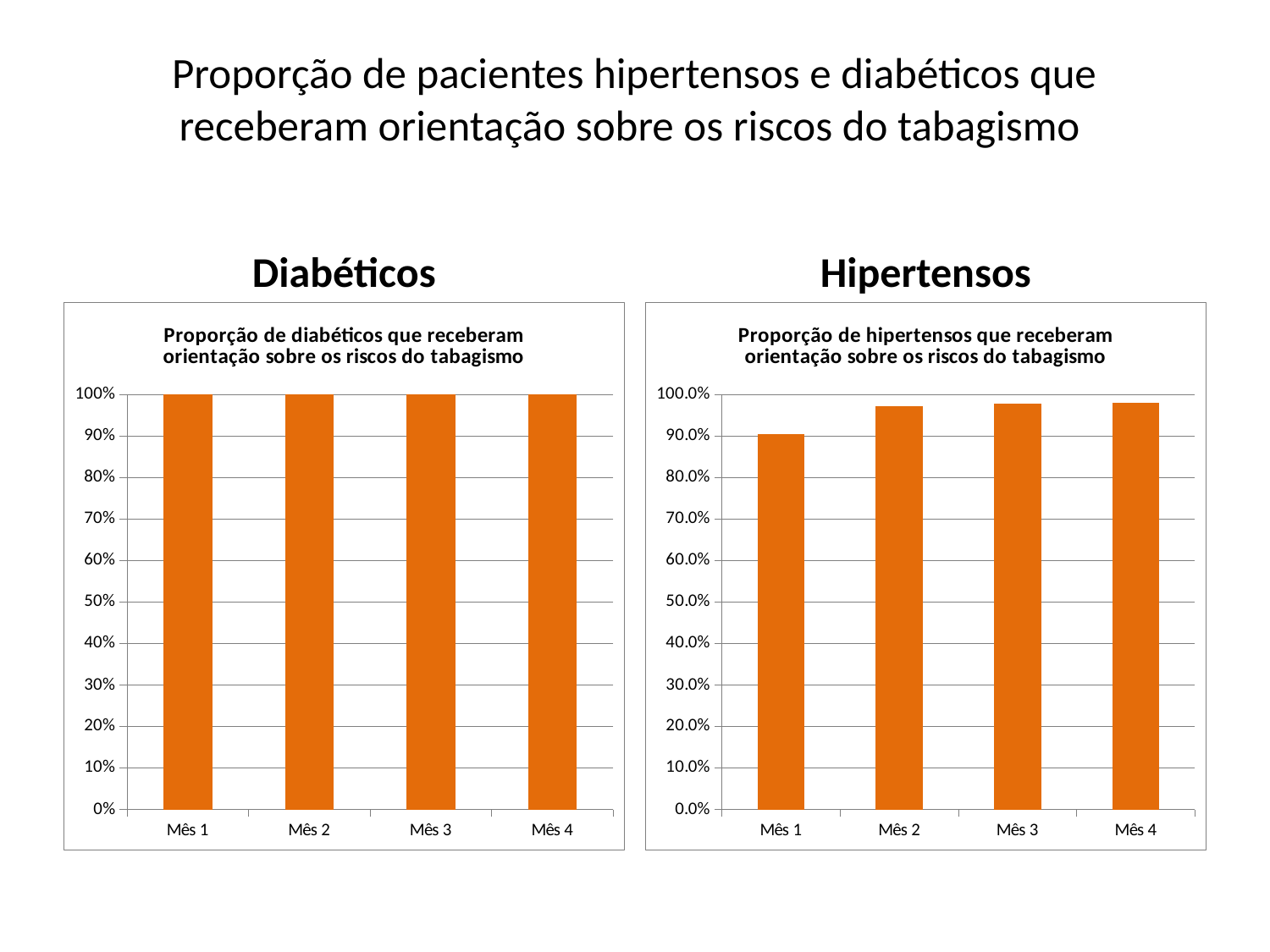
In the Hipertensos chart, which month has the lowest value? Mês 1 In the Diabéticos chart, what is the value for Mês 1? 100% What colour are the bars in the Hipertensos chart? Orange In the Hipertensos chart, is the value for Mês 2 greater or less than 100.0%? less In the Hipertensos chart, is the value for Mês 1 greater or less than 80.0%? greater In the Diabéticos chart, do the values rise, fall or stay the same from Mês 1 to Mês 4? Stay the same In the Hipertensos chart, do the values generally rise or fall from Mês 1 to Mês 4? Rise In the Diabéticos chart, how many months are plotted? 4 In the Hipertensos chart, which is larger, the value for Mês 1 or Mês 2? Mês 2 What kind of chart is the Diabéticos chart? Bar chart In the Diabéticos chart, what is the value for Mês 4? 100% In the Hipertensos chart, is the value for Mês 3 greater or less than 90.0%? greater